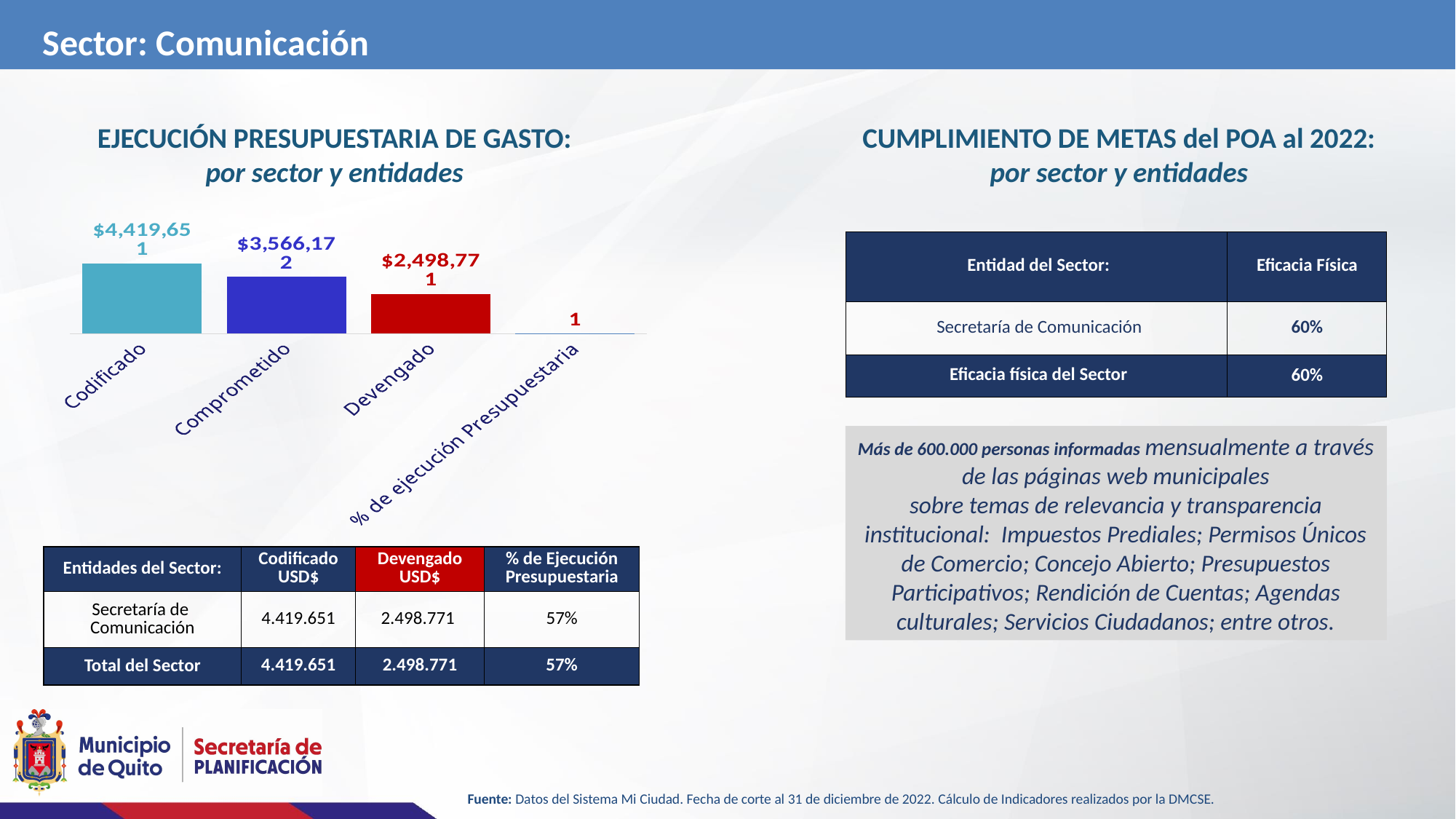
What is the value shown for Codificado in the bar chart? $4,419,651 Which is larger in the bar chart, Comprometido or Devengado? Comprometido What is the value shown for Devengado in the bar chart? $2,498,771 What is the difference between the Codificado and Comprometido values in the bar chart? $853,479 What is the value shown for Comprometido in the bar chart? $3,566,172 What type of chart is shown on the slide? Bar chart What is the difference between the Codificado and Devengado values in the bar chart? $1,920,880 Which category has the highest value in the bar chart? Codificado How many categories are shown in the bar chart? 4 Which category has the lowest value in the bar chart? % de ejecución Presupuestaria What value is labelled for % de ejecución Presupuestaria in the bar chart? 1 Do the values in the bar chart rise or fall from left to right? Fall